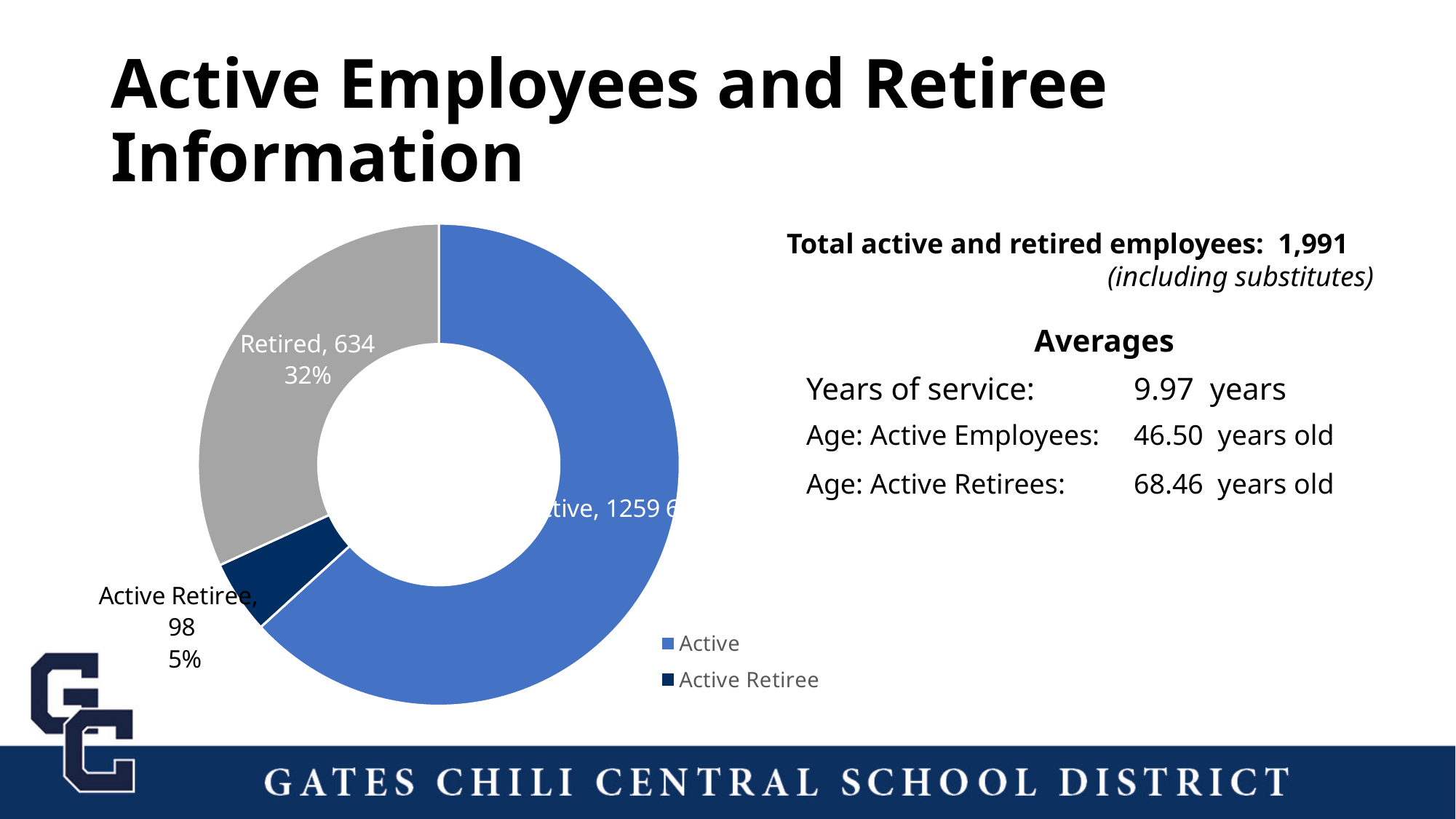
What is the value for Retired in the chart? 634 What share of the chart does the Retired slice represent? 32% How many categories are shown in the chart? 3 What share of the chart does the Active Retiree slice represent? 5% Which is larger, the Retired value or the Active Retiree value? Retired What is the difference between the Retired value and the Active Retiree value? 536 What kind of chart is shown on the slide? doughnut chart What is the value for Active in the chart? 1259 What is the value for Active Retiree in the chart? 98 Which category has the smallest slice in the chart? Active Retiree Which category has the largest slice in the chart? Active What is the difference between the Active value and the Retired value? 625